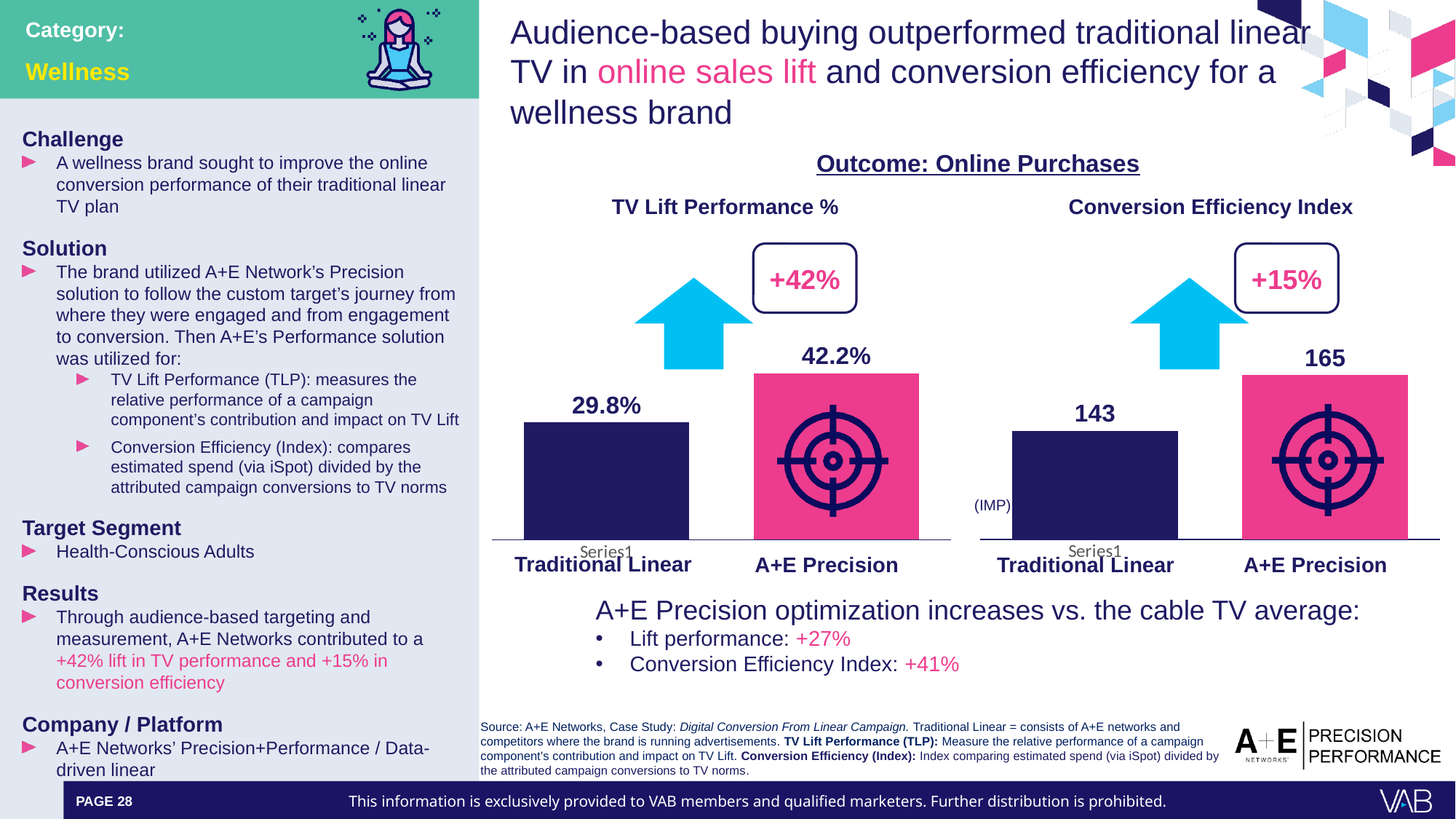
In the TV Lift Performance % chart, what is the value for Traditional Linear? 29.8% What type of chart is the Conversion Efficiency Index chart? bar chart In the Conversion Efficiency Index chart, how much higher is A+E Precision than Traditional Linear? 22 In the Conversion Efficiency Index chart, what is the value for A+E Precision? 165 In the TV Lift Performance % chart, what is the value for A+E Precision? 42.2% In the Conversion Efficiency Index chart, what is the value for Traditional Linear? 143 How many categories are shown in the TV Lift Performance % chart? 2 What percentage increase is shown in the callout above the TV Lift Performance % chart? +42% In the Conversion Efficiency Index chart, which category has the lower value? Traditional Linear In the TV Lift Performance % chart, what is the difference between A+E Precision and Traditional Linear? 12.4 percentage points In the Conversion Efficiency Index chart, is the value for Traditional Linear larger or smaller than the value for A+E Precision? smaller In the TV Lift Performance % chart, which category has the higher value? A+E Precision